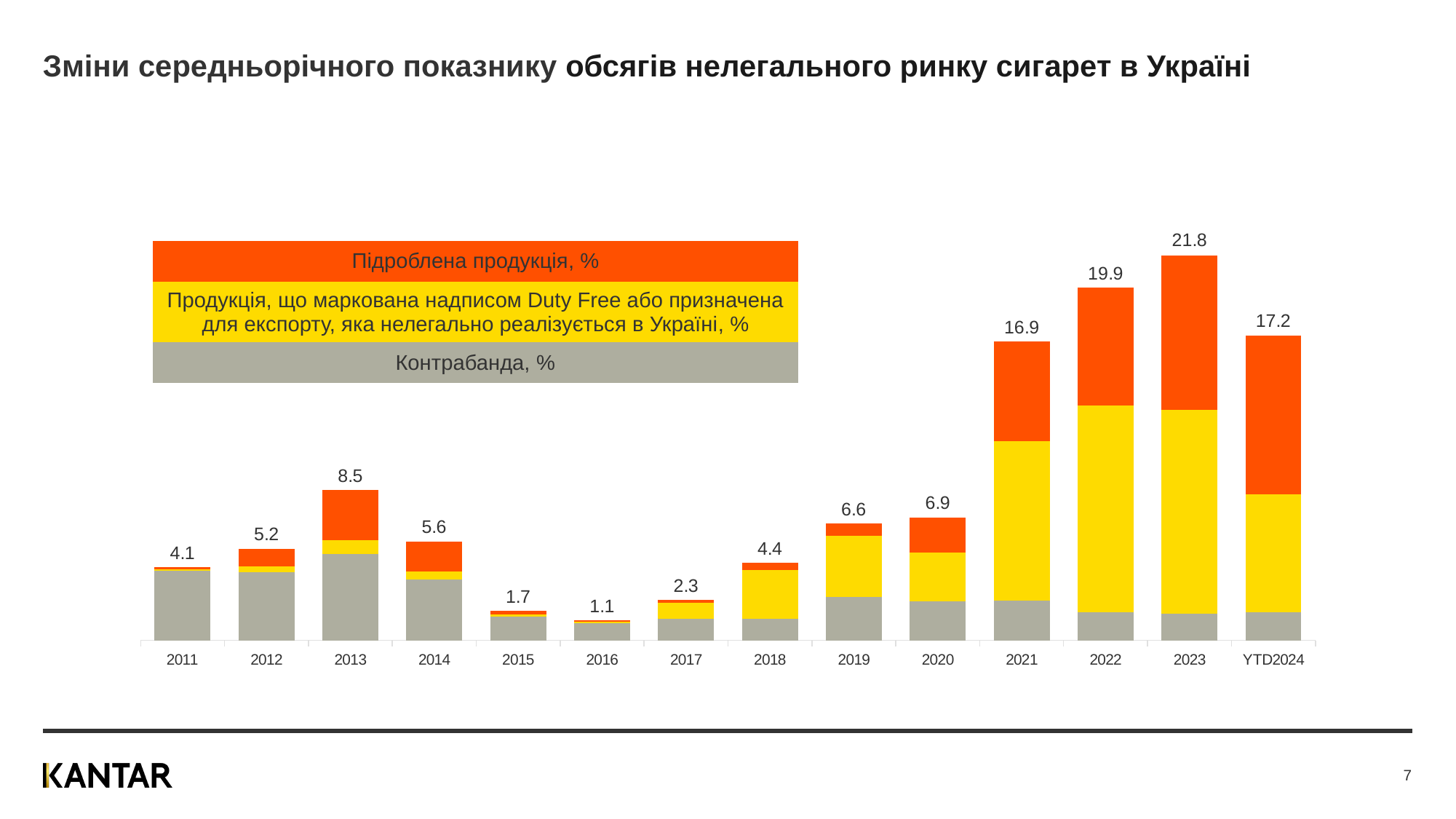
Which year has the lowest total illegal market share? 2016 How many time periods are shown on the x axis? 14 What is the difference between the totals for 2023 and 2022? 1.9 What kind of chart is shown on the slide? Stacked bar chart How many series does the legend list? 3 What is the total value shown for 2016? 1.1 What is the difference between the totals for 2021 and 2020? 10 Which year has the highest total illegal market share? 2023 What is the total value shown for YTD2024? 17.2 What is the total illegal cigarette market share shown for 2023? 21.8 Which series is shown in grey in the legend? Контрабанда, % Which year has a larger total, 2013 or 2014? 2013